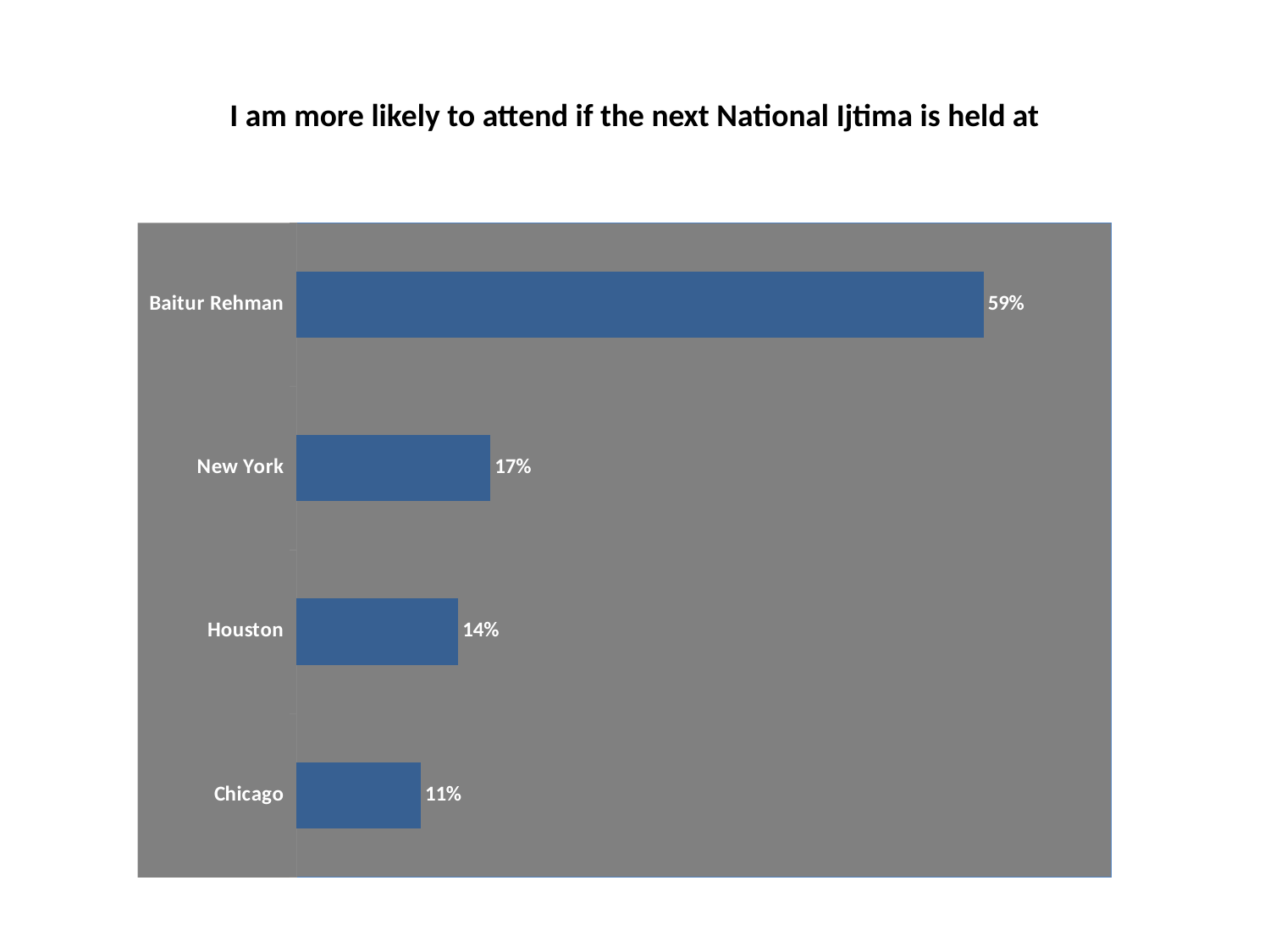
How many locations are shown in the chart? 4 What is the value shown for Houston? 14% What is the difference between the values for Houston and Chicago? 3% What kind of chart is shown on the slide? Bar chart What percentage of respondents are more likely to attend if the next National Ijtima is held at Baitur Rehman? 59% What is the difference between the values for Baitur Rehman and New York? 42% What is the value shown for New York? 17% Which location has the highest value? Baitur Rehman What is the title of the chart? I am more likely to attend if the next National Ijtima is held at Which has a larger value, New York or Houston? New York Which location has the lowest value? Chicago What is the value shown for Chicago? 11%